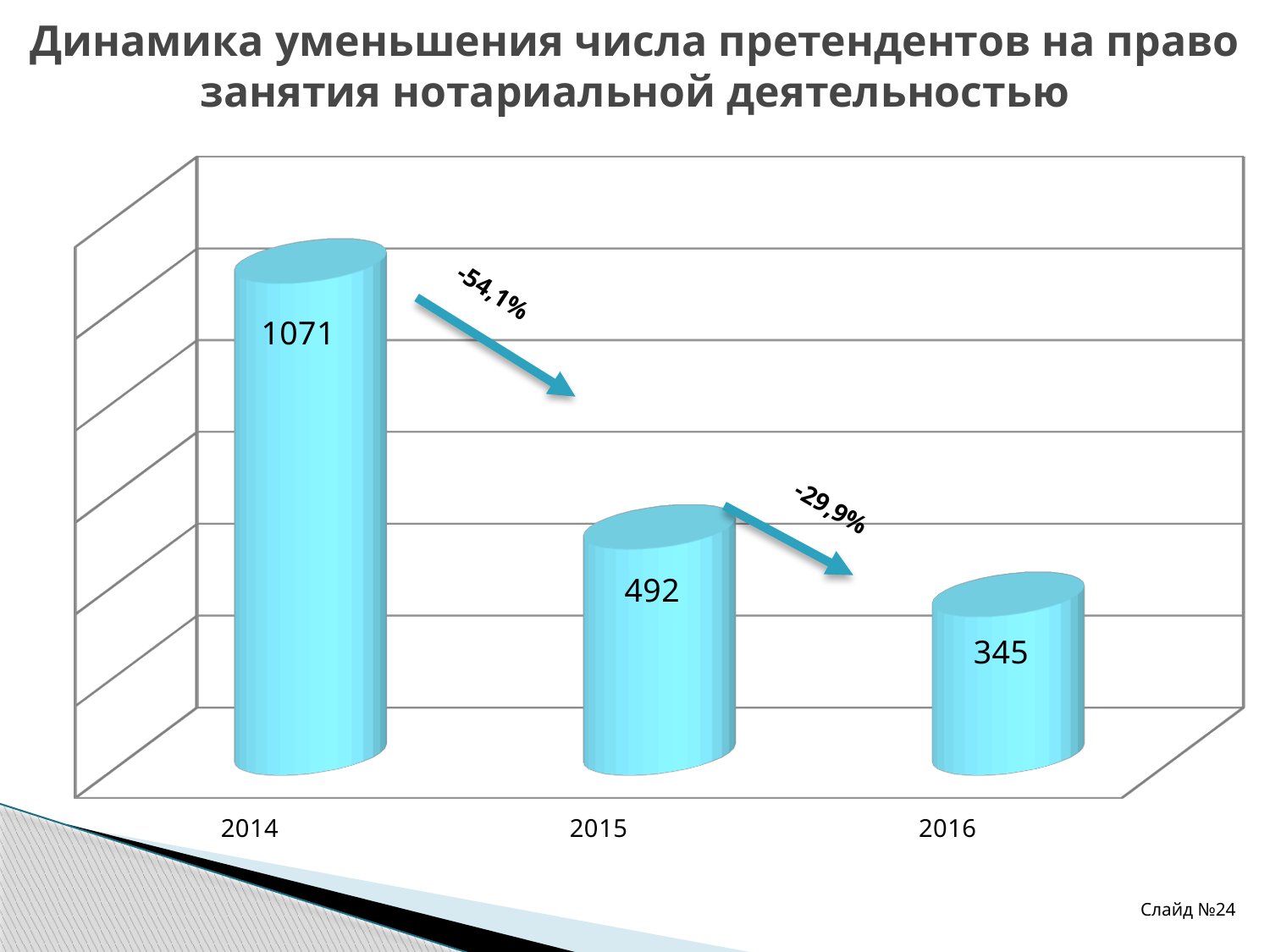
Which is larger, the value for 2015 or the value for 2016? 2015 Do the values rise or fall from 2014 to 2016? fall Which year has the lowest value? 2016 What is the difference between the values for 2014 and 2015? 579 What percentage change is labelled on the arrow between 2014 and 2015? -54,1% What kind of chart is shown on the slide? bar chart How many years are shown on the chart? 3 What is the value for 2016? 345 What is the value for 2015? 492 Which year has the highest value? 2014 What is the value for 2014? 1071 What is the difference between the values for 2015 and 2016? 147